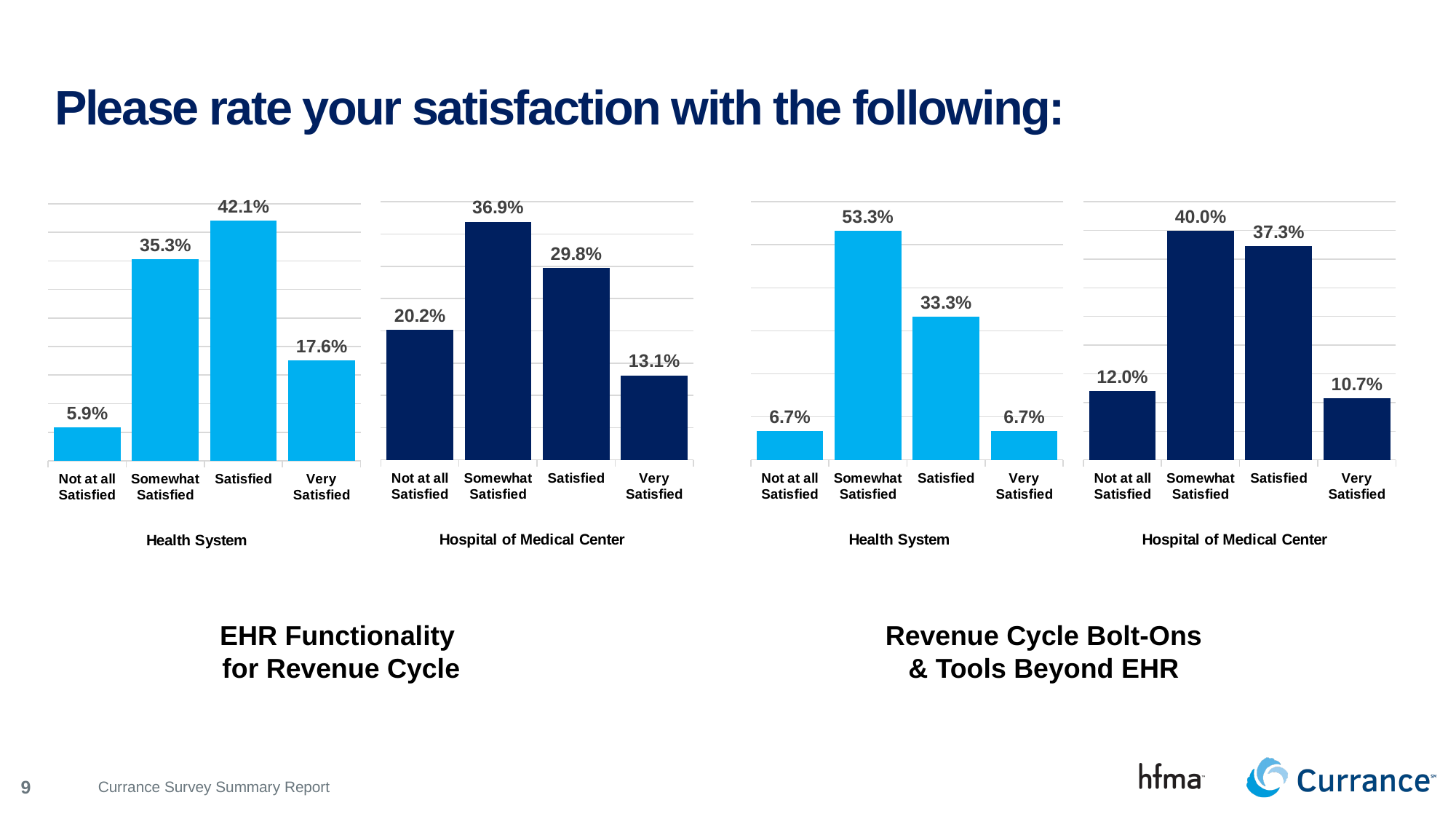
In the Revenue Cycle Bolt-Ons & Tools Beyond EHR chart, what is the difference between the Somewhat Satisfied and Satisfied percentages for Hospital of Medical Center? 2.7% How many satisfaction levels are shown for each group in the Revenue Cycle Bolt-Ons & Tools Beyond EHR chart? 4 In the Revenue Cycle Bolt-Ons & Tools Beyond EHR chart, what percentage of Hospital of Medical Center respondents were Very Satisfied? 10.7% In the Revenue Cycle Bolt-Ons & Tools Beyond EHR chart, what percentage of Health System respondents were Somewhat Satisfied? 53.3% In the Revenue Cycle Bolt-Ons & Tools Beyond EHR chart, which satisfaction level has the lowest percentage for Hospital of Medical Center? Very Satisfied In the EHR Functionality for Revenue Cycle chart, what percentage of Health System respondents were Satisfied? 42.1% In the EHR Functionality for Revenue Cycle chart, what percentage of Hospital of Medical Center respondents were Not at all Satisfied? 20.2% In the EHR Functionality for Revenue Cycle chart, which is larger: the Very Satisfied percentage for Health System or for Hospital of Medical Center? Health System What type of chart is used on this slide? Bar chart In the EHR Functionality for Revenue Cycle chart, which satisfaction level has the highest percentage for Hospital of Medical Center? Somewhat Satisfied In the EHR Functionality for Revenue Cycle chart, what is the difference between the Satisfied and Somewhat Satisfied percentages for Health System? 6.8% In the EHR Functionality for Revenue Cycle chart, which satisfaction level has the lowest percentage for Health System? Not at all Satisfied